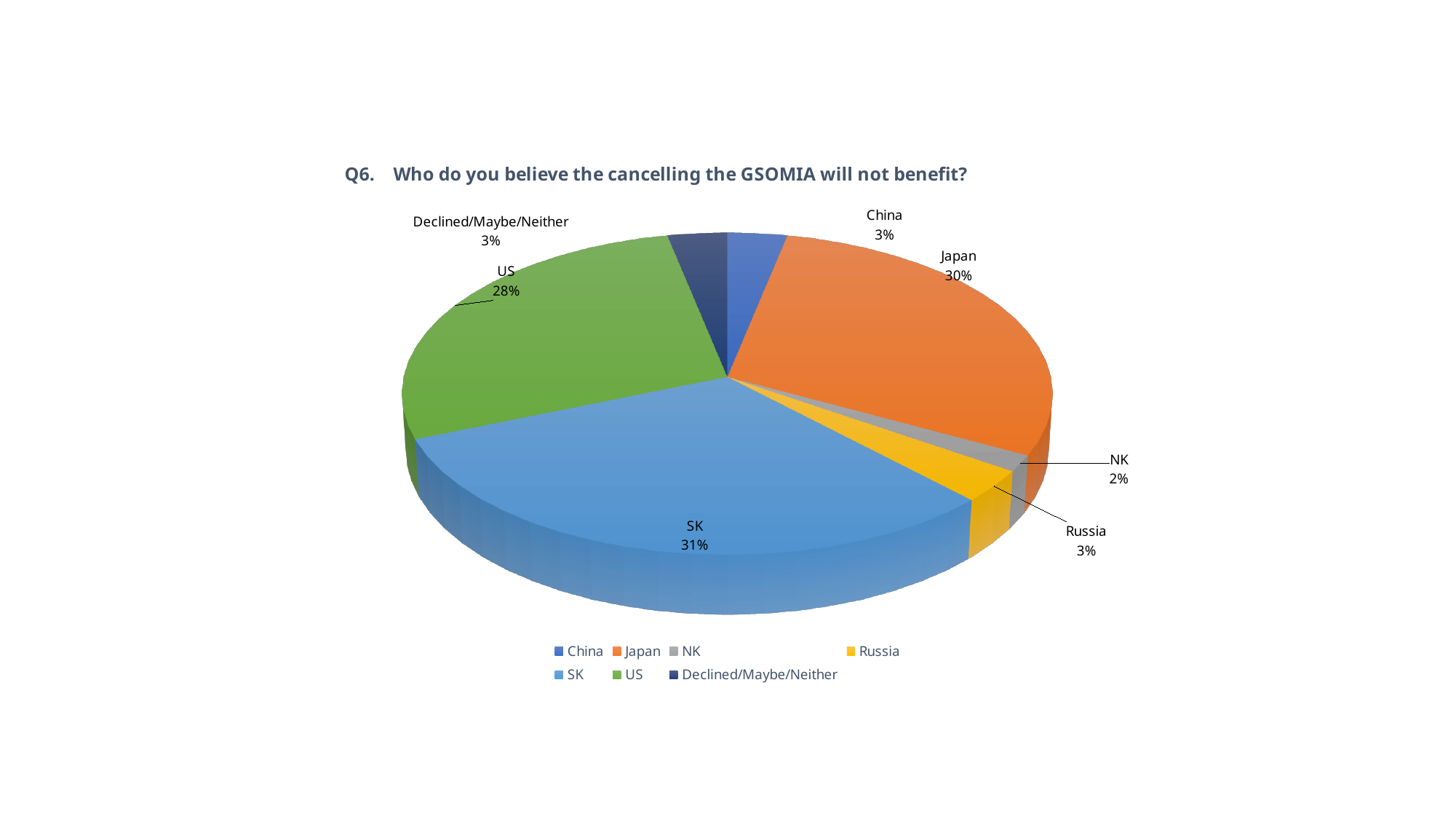
How many categories does the pie chart show? 7 Which category has the largest slice of the pie? SK What percentage is shown for the US? 28% What percentage is shown for NK? 2% What percentage is shown for Russia? 3% What is the title of the chart? Q6. Who do you believe the cancelling the GSOMIA will not benefit? What share of the pie does SK hold? 31% Which is larger, the share for Japan or the share for the US? Japan What is the difference in percentage points between SK and the US? 3 What percentage is shown for Japan? 30% Which category has the smallest slice of the pie? NK What kind of chart is shown on the slide? Pie chart